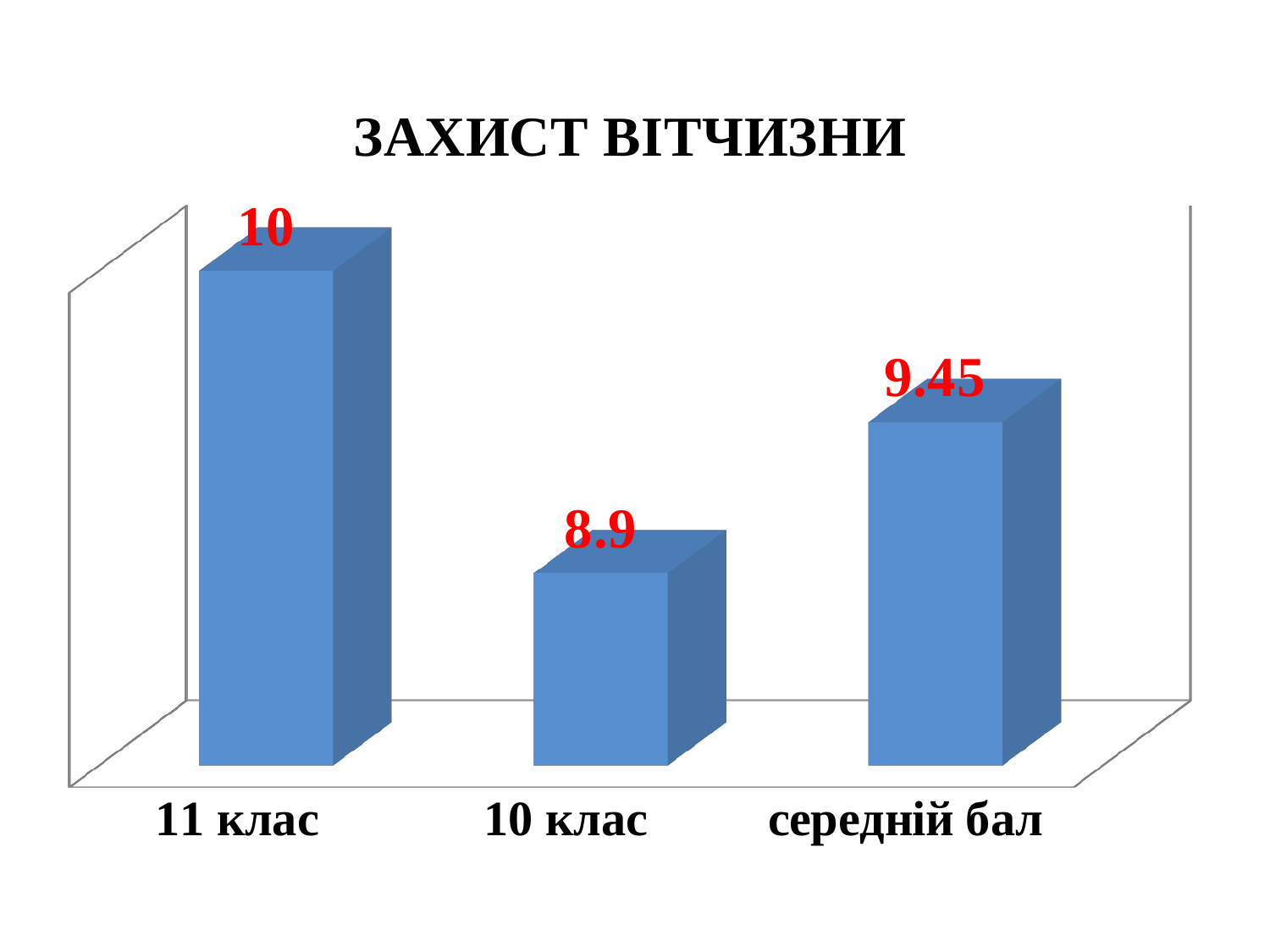
How many categories are shown on the chart? 3 What is the value for середній бал? 9.45 What colour are the bars in the chart? blue What is the difference between the values for середній бал and 10 клас? 0.55 What kind of chart is shown on the slide? bar chart Which category has the lowest value? 10 клас Which category has the highest value? 11 клас What is the value for 11 клас? 10 Which is larger, the value for 10 клас or the value for середній бал? середній бал What is the title of the chart? ЗАХИСТ ВІТЧИЗНИ What is the value for 10 клас? 8.9 What is the difference between the values for 11 клас and 10 клас? 1.1